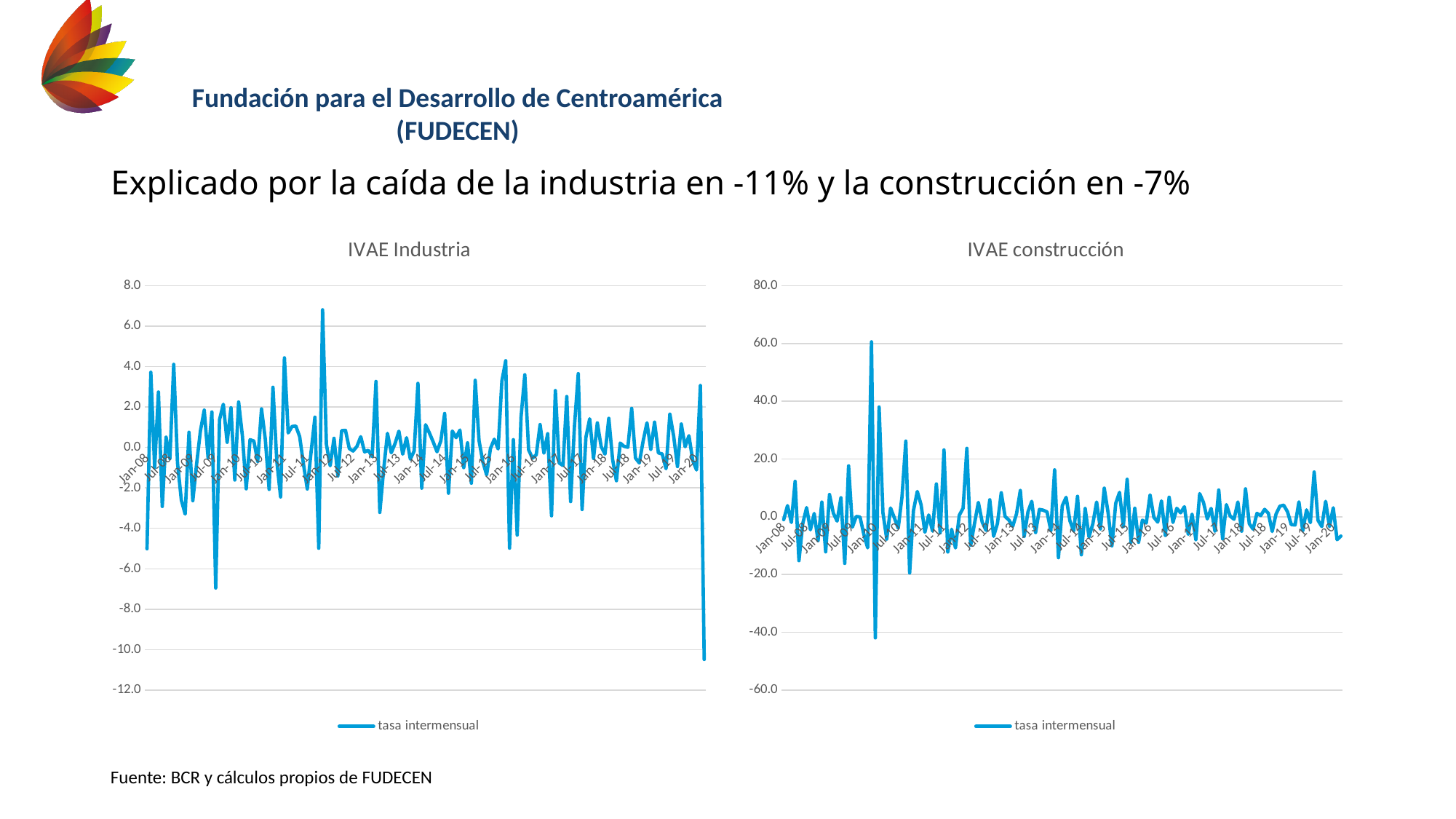
How many series does the legend of the IVAE Industria chart list? 1 What kind of chart is the IVAE construcción chart? line chart In the IVAE Industria chart, is the highest peak, near Jan-12, greater or less than 6.0? greater In the IVAE construcción chart, is the highest peak, near Jan-10, greater or less than 40.0? greater In the IVAE Industria chart, around which date does the series reach its lowest value? Jan-20 (end of the series) In the IVAE Industria chart, is the lowest value, at the end of the series near Jan-20, greater or less than -10.0? less What is the legend entry shown under the IVAE construcción chart? tasa intermensual What is the highest value shown on the y axis of the IVAE construcción chart? 80.0 What is the title of the chart on the right side of the slide? IVAE construcción In the IVAE construcción chart, around which date does the series reach its highest value? Jan-10 What kind of chart is the IVAE Industria chart? line chart